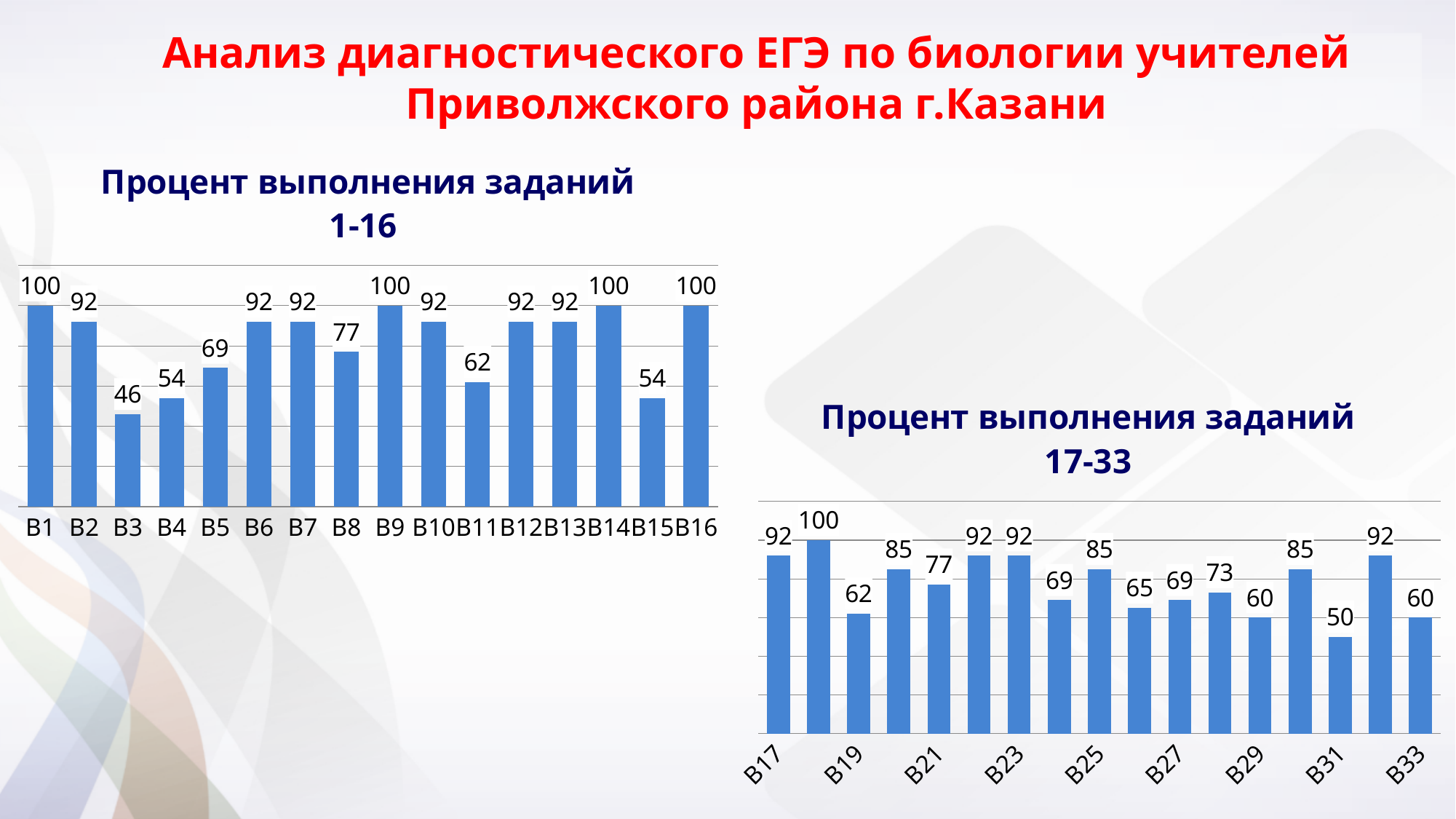
In the chart 'Процент выполнения заданий 17-33', what is the value for B21? 77 In the chart 'Процент выполнения заданий 1-16', which category has the lowest value? B3 In the chart 'Процент выполнения заданий 17-33', what is the value for B31? 50 In the chart 'Процент выполнения заданий 17-33', which is larger, the value for B25 or the value for B29? B25 In the chart 'Процент выполнения заданий 17-33', what is the difference between the values for B17 and B19? 30 In the chart 'Процент выполнения заданий 1-16', what is the value for B3? 46 What type of chart is 'Процент выполнения заданий 17-33'? Bar chart In the chart 'Процент выполнения заданий 1-16', which is larger, the value for B5 or the value for B15? B5 In the chart 'Процент выполнения заданий 1-16', what is the difference between the values for B1 and B11? 38 How many bars are plotted in the chart 'Процент выполнения заданий 1-16'? 16 In the chart 'Процент выполнения заданий 1-16', what is the value for B8? 77 In the chart 'Процент выполнения заданий 17-33', which category has the lowest value? B31